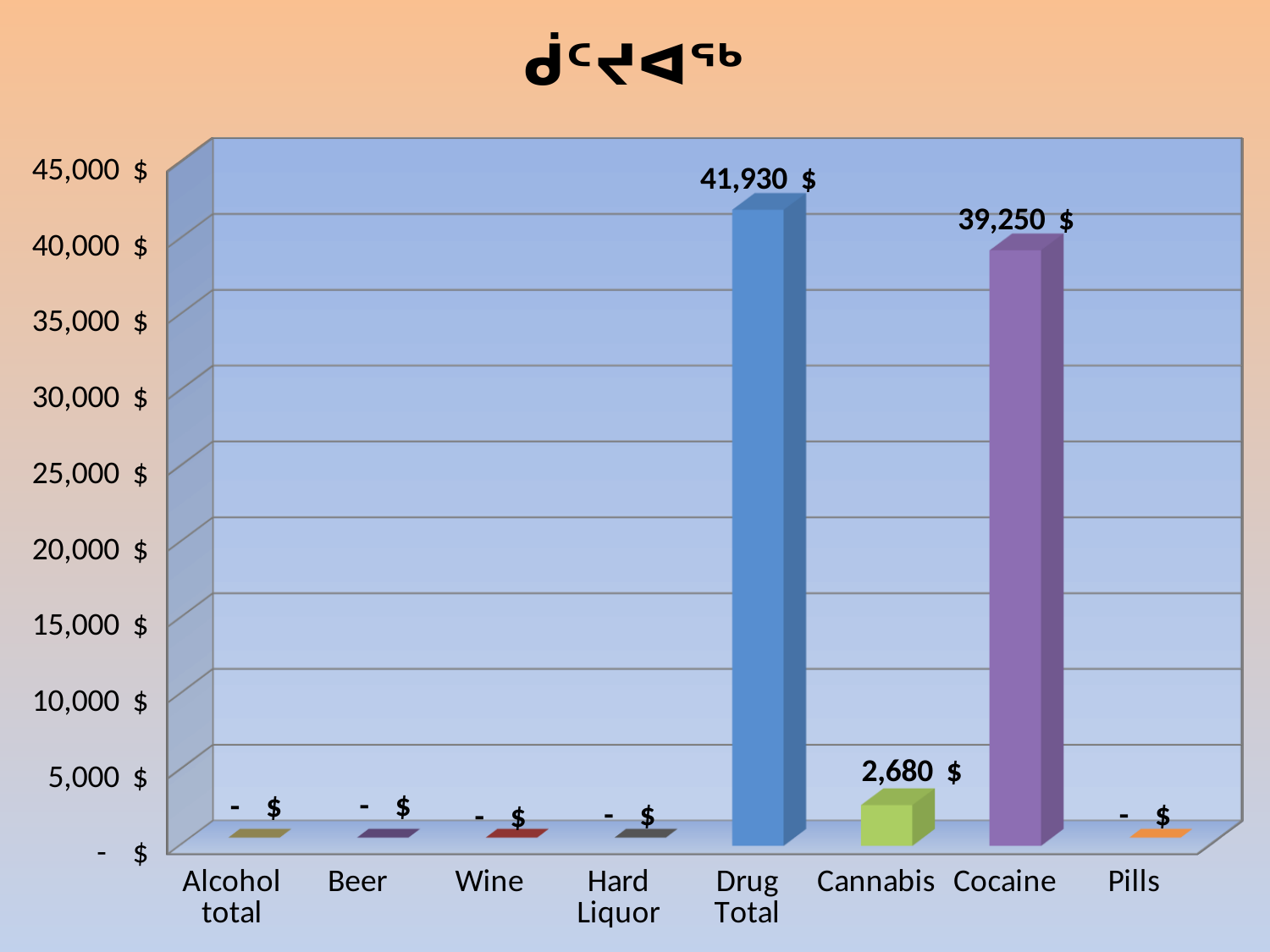
What is the data label shown for Beer? - $ How many categories are shown on the x axis? 8 What is the value for Cannabis? 2,680 $ Is the value for Cannabis greater or less than 5,000 $? less What is the difference between the values for Drug Total and Cocaine? 2,680 $ Which category has the highest value? Drug Total What is the value for Drug Total? 41,930 $ What kind of chart is shown on the slide? Bar chart Which is larger, the value for Cocaine or the value for Cannabis? Cocaine What is the difference between the values for Cocaine and Cannabis? 36,570 $ Is the value for Cocaine greater or less than 35,000 $? greater What is the value for Cocaine? 39,250 $